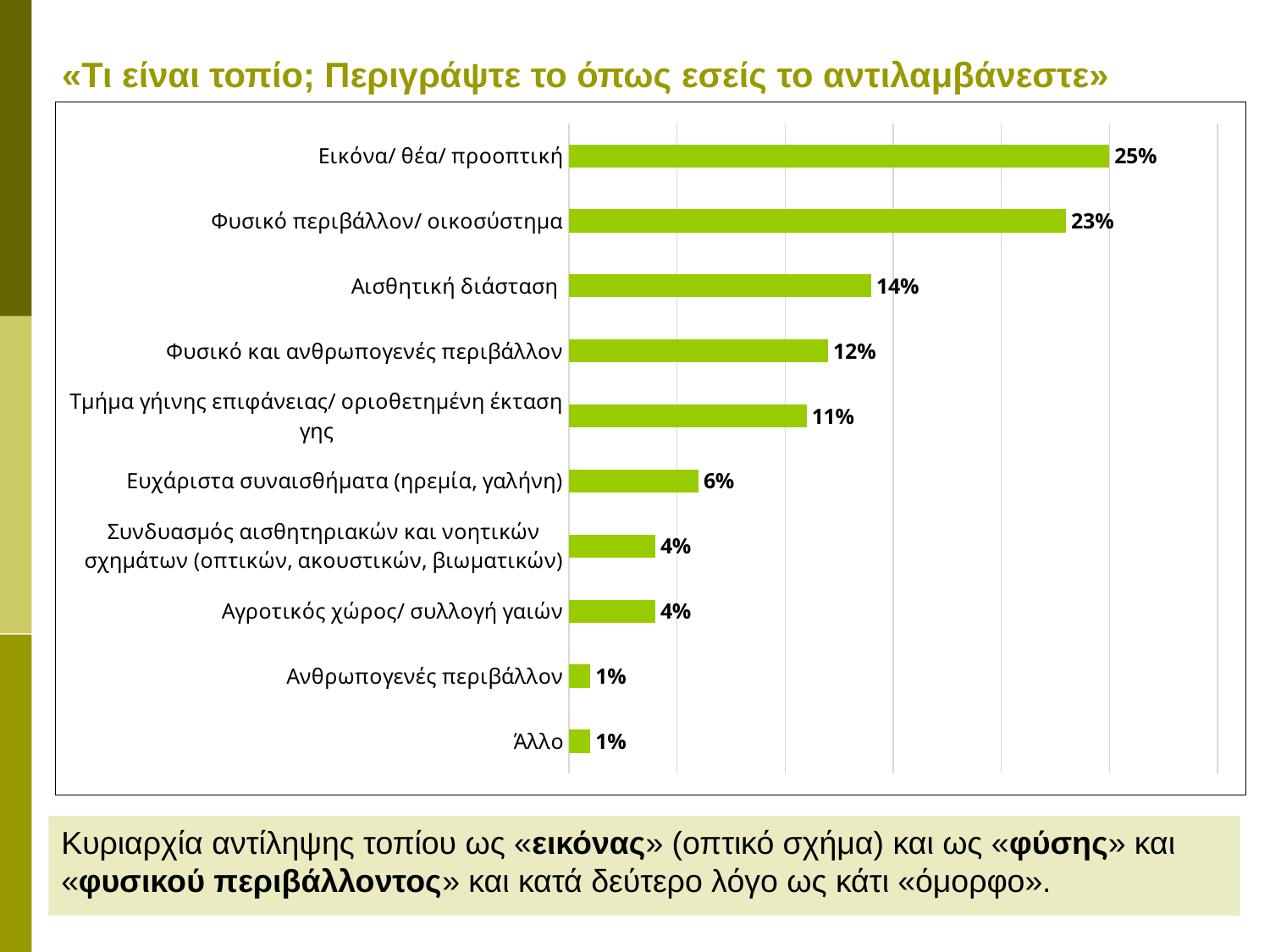
What is the value for Ανθρωπογενές περιβάλλον? 1% What is the value for Αισθητική διάσταση? 14% Which is larger, the value for Τμήμα γήινης επιφάνειας/ οριοθετημένη έκταση γης or the value for Ευχάριστα συναισθήματα (ηρεμία, γαλήνη)? Τμήμα γήινης επιφάνειας/ οριοθετημένη έκταση γης Which category has the highest value? Εικόνα/ θέα/ προοπτική What is the difference between the values for Εικόνα/ θέα/ προοπτική and Φυσικό περιβάλλον/ οικοσύστημα? 2% What is the value for Εικόνα/ θέα/ προοπτική? 25% What colour are the bars in the chart? Green What is the value for Ευχάριστα συναισθήματα (ηρεμία, γαλήνη)? 6% What is the value for Φυσικό περιβάλλον/ οικοσύστημα? 23% How many categories are shown in the chart? 10 What kind of chart is shown on the slide? Bar chart What is the difference between the values for Αισθητική διάσταση and Φυσικό και ανθρωπογενές περιβάλλον? 2%